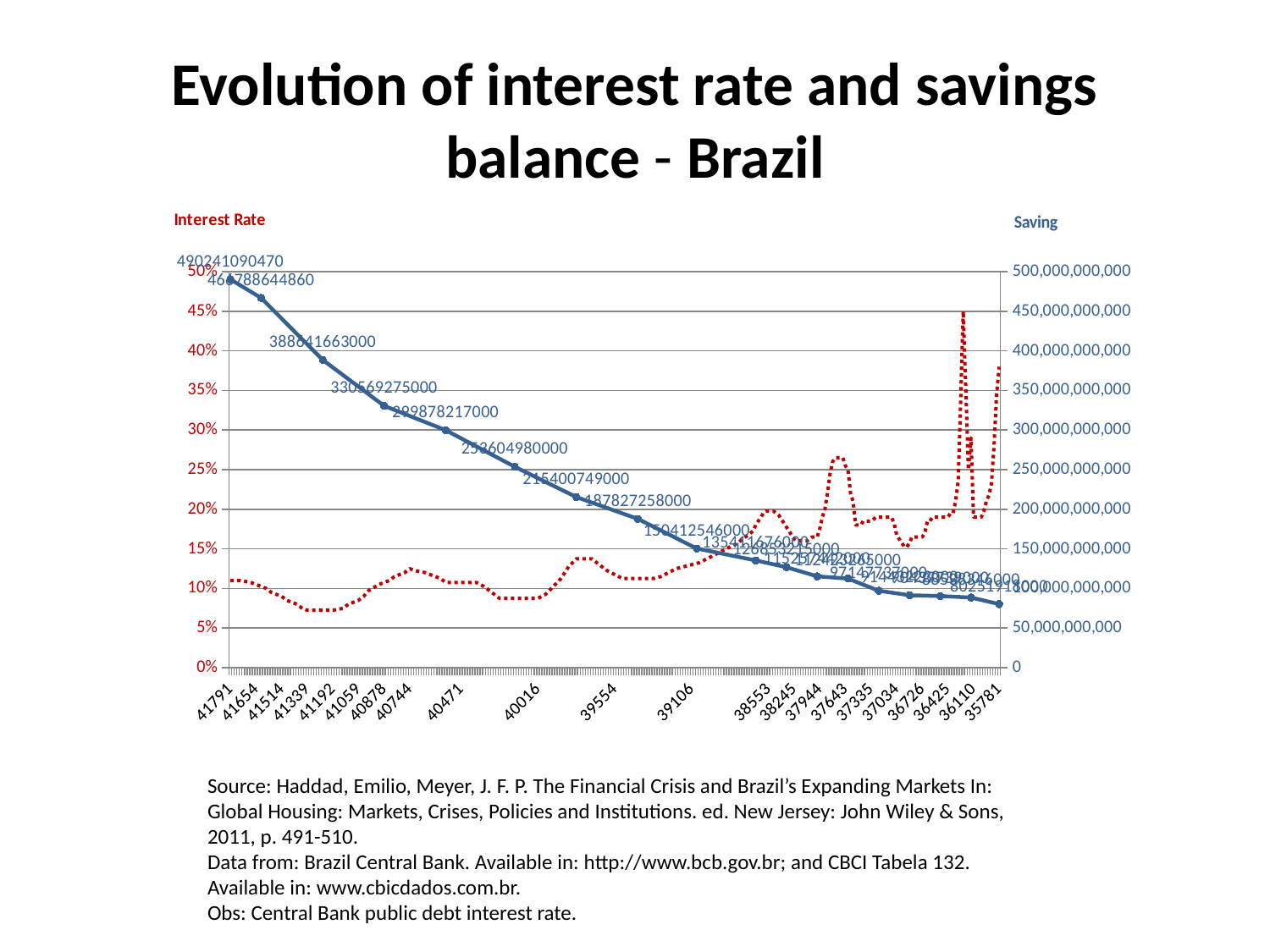
Does the Saving series rise or fall from left to right along the x axis? fall What is the Saving value labelled at the third data point of the Saving series? 388641663000 How many data series are plotted on the chart? 2 Is the peak of the Interest Rate series near x label 36110 greater or less than 40%? greater What kind of chart is shown on the slide? line chart What is the title of the right vertical axis? Saving What is the title of the left vertical axis? Interest Rate What is the highest Saving value labelled on the chart? 490241090470 Is the Interest Rate at the first x-axis label (41791) greater or less than 15%? less What is the difference between the first two labelled Saving values, 490241090470 and 466788644860? 23452445610 How many labels are shown on the x axis? 22 What is the Saving value labelled at the second data point of the Saving series? 466788644860